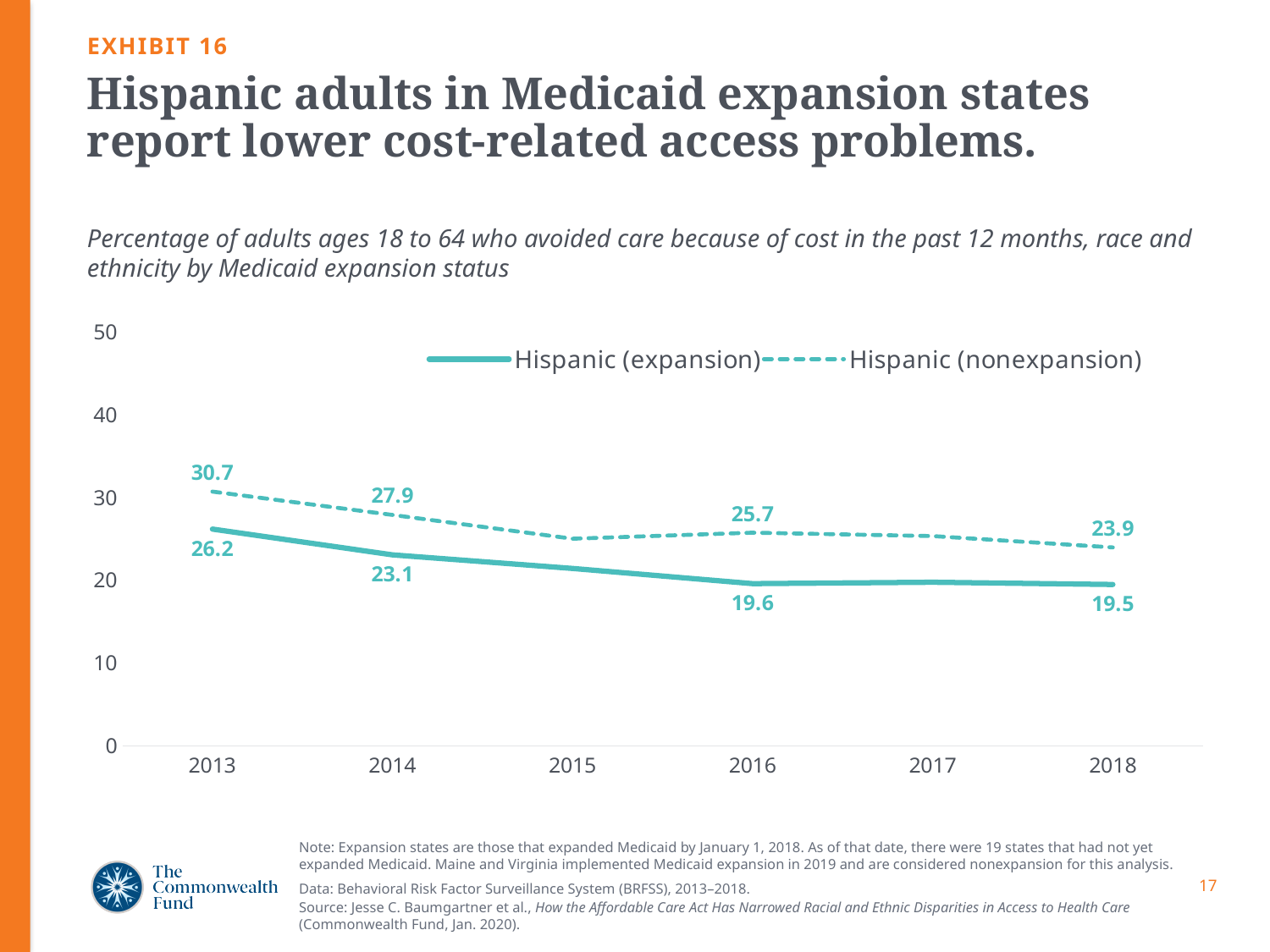
How many series does the legend list? 2 What is the difference between the Hispanic (nonexpansion) and Hispanic (expansion) values in 2013? 4.5 How many years are shown on the x axis? 6 In which year is the Hispanic (expansion) value lowest? 2018 In which year is the Hispanic (nonexpansion) value highest? 2013 What is the value for Hispanic (expansion) in 2013? 26.2 What is the value for Hispanic (nonexpansion) in 2018? 23.9 What is the difference between the Hispanic (nonexpansion) and Hispanic (expansion) values in 2018? 4.4 What is the value for Hispanic (expansion) in 2016? 19.6 Is the value for Hispanic (expansion) in 2015 greater or less than 30? less What is the value for Hispanic (nonexpansion) in 2014? 27.9 Which series has the higher value in 2016, Hispanic (expansion) or Hispanic (nonexpansion)? Hispanic (nonexpansion)